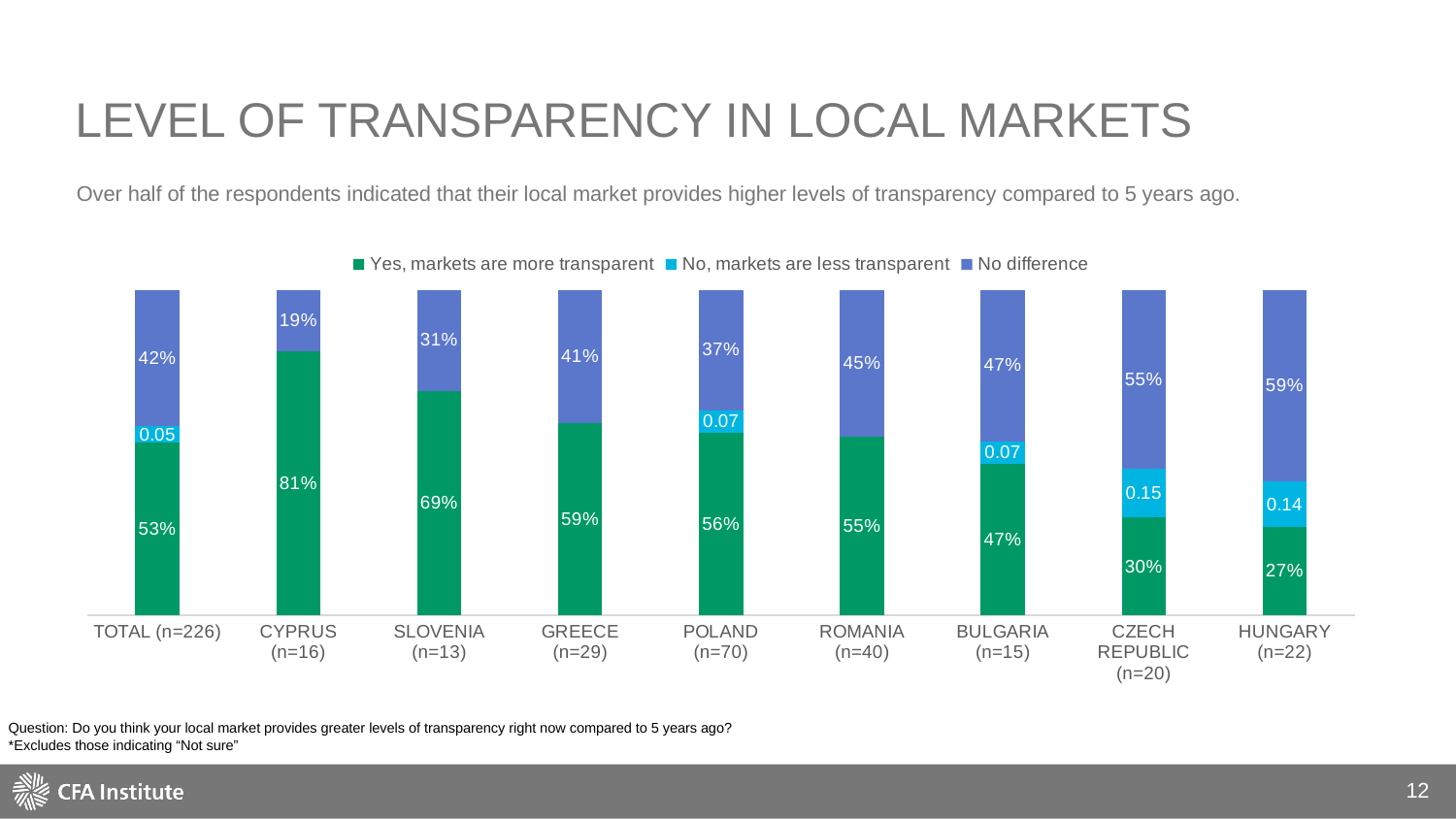
Which category has the highest 'Yes, markets are more transparent' value? CYPRUS (n=16) Which category has the lowest 'Yes, markets are more transparent' value? HUNGARY (n=22) What is the difference between the 'Yes, markets are more transparent' values for Slovenia (n=13) and Greece (n=29)? 10% What kind of chart is shown on the slide? stacked bar chart How many country/total categories are shown on the x axis? 9 How many series does the legend list? 3 What is the 'No, markets are less transparent' value for Czech Republic (n=20)? 0.15 Which is larger: the 'No difference' value for Romania (n=40) or for Poland (n=70)? Romania (n=40) Which legend entry is shown in green? Yes, markets are more transparent What is the 'No difference' value for Hungary (n=22)? 59% What is the 'Yes, markets are more transparent' value for TOTAL (n=226)? 53% What percentage of respondents in Cyprus (n=16) said markets are more transparent? 81%